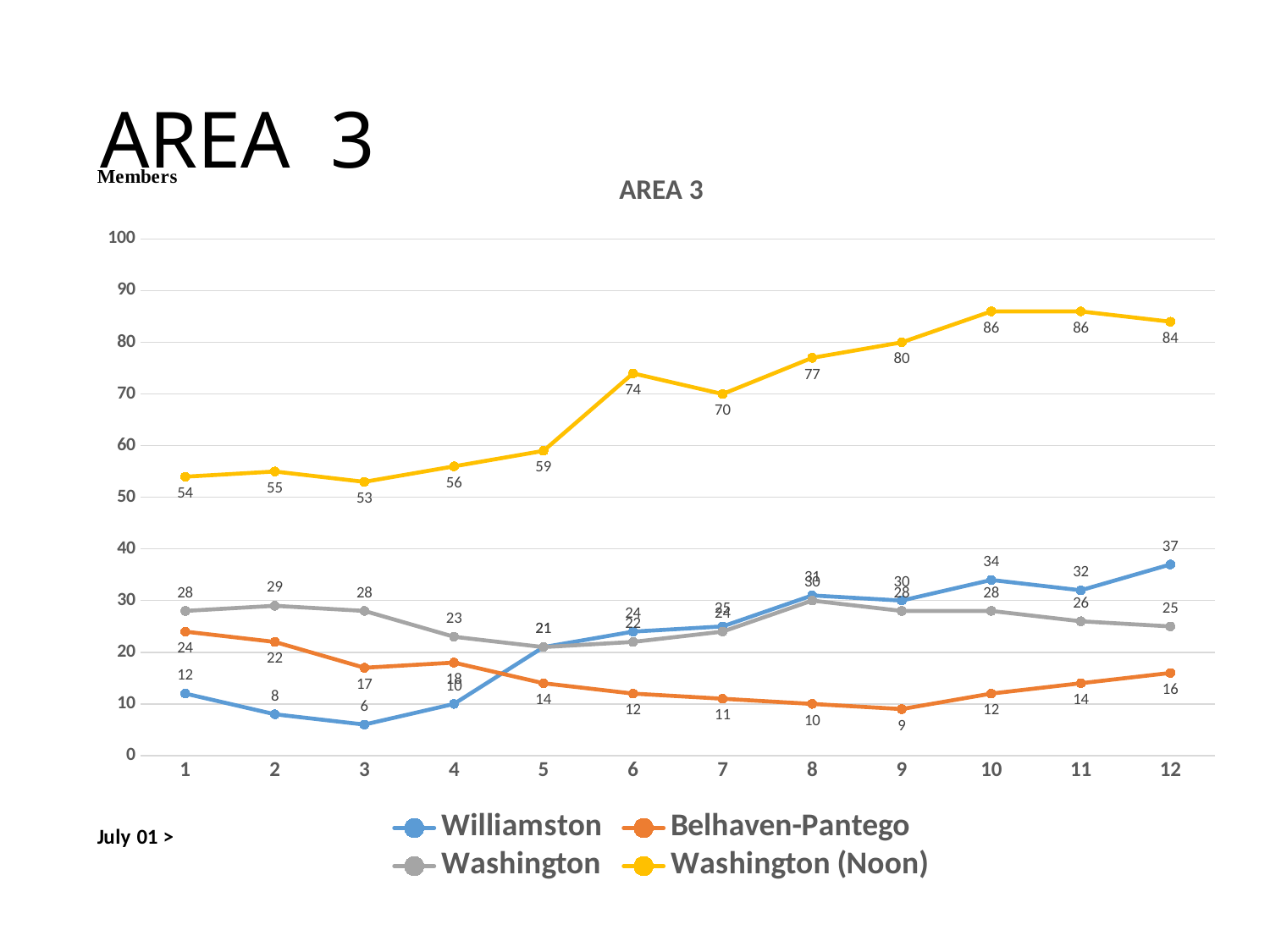
Does the Washington (Noon) series generally rise or fall from point 1 to point 12? rise How many series does the legend list? 4 What kind of chart is shown on the slide? line chart What is the value for Belhaven-Pantego at point 9? 9 How many points are plotted along the x axis for each series? 12 What is the value for Washington (Noon) at point 12? 84 What is the difference between Washington (Noon) and Williamston at point 12? 47 At point 1, which is larger: Washington or Belhaven-Pantego? Washington At which x-axis point is the Washington (Noon) series lowest? 3 What is the value for Williamston at point 3? 6 At which x-axis point is the Williamston series highest? 12 Is the value for Washington (Noon) at point 6 greater or less than 70? greater